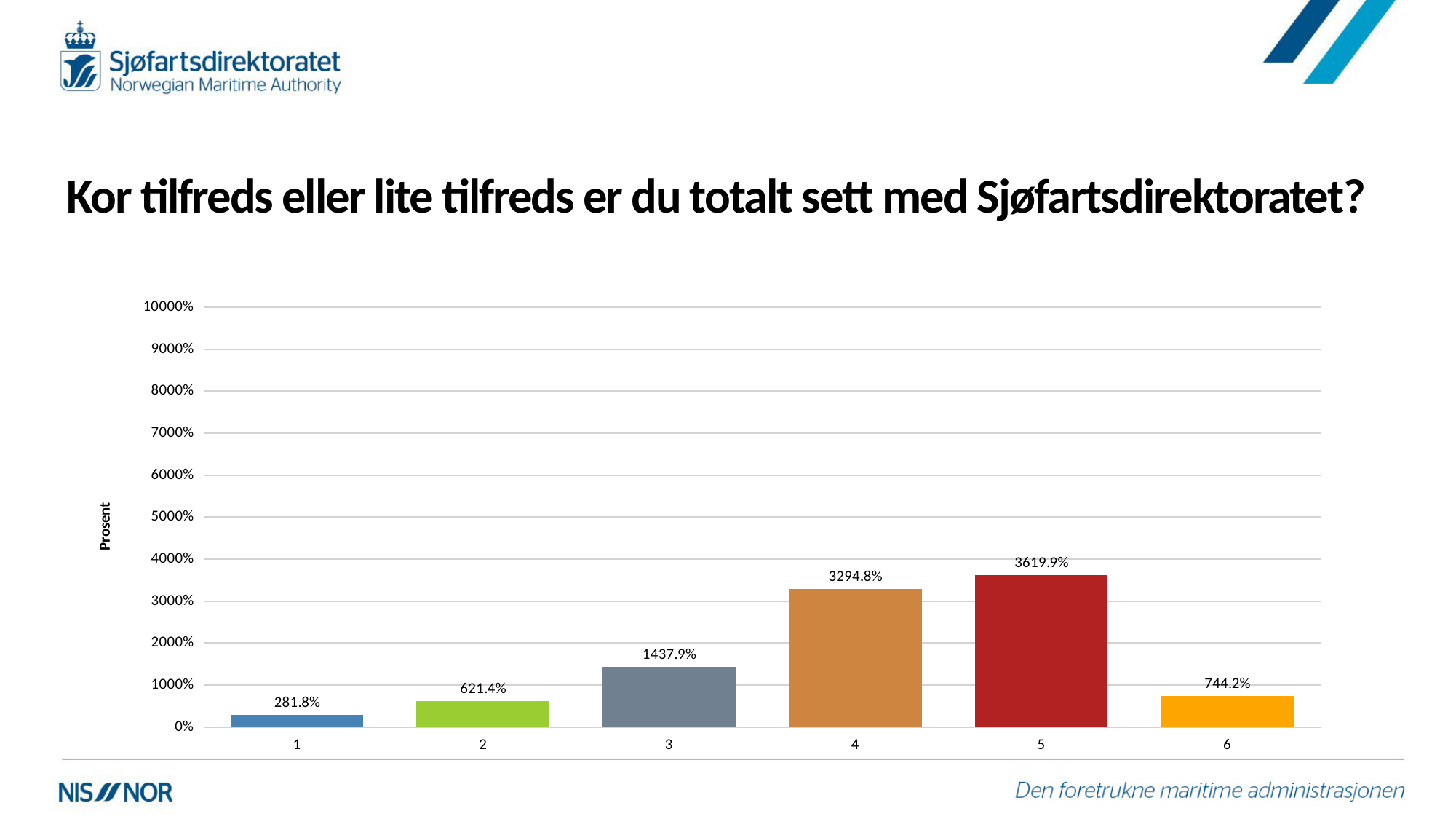
What kind of chart is shown on the slide? bar chart What is the value for category 6? 744.2% Is the value for category 2 greater or less than 1000%? less What is the difference between the values for category 5 and category 4? 325.1% Which is larger, the value for category 3 or the value for category 6? 3 How many categories are shown on the x axis? 6 Do the values rise or fall from category 1 to category 5? rise What is the label of the y axis? Prosent Which category has the highest value? 5 What is the value for category 1? 281.8% Which category has the lowest value? 1 What is the value for category 4? 3294.8%